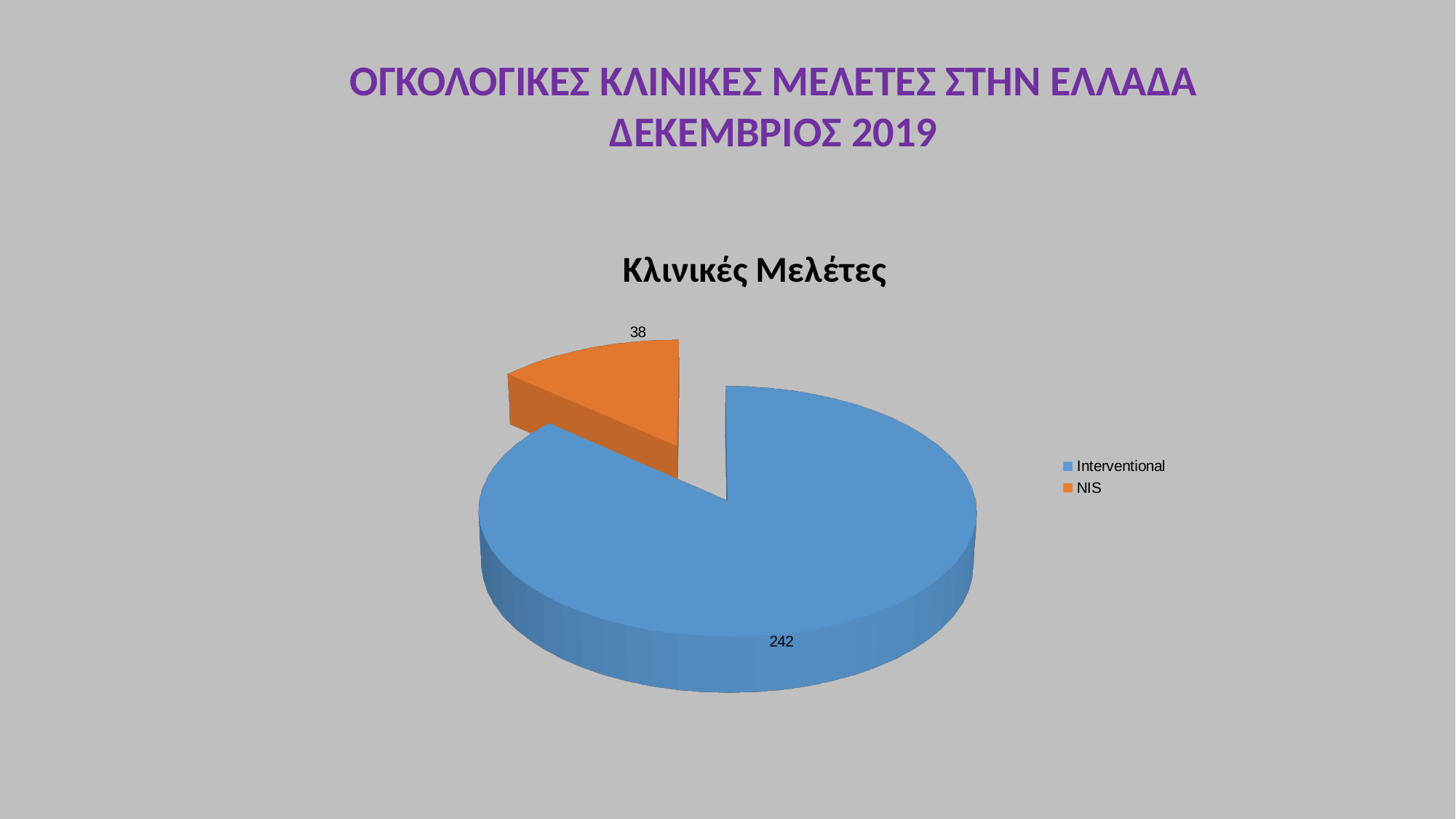
What is the title of the chart? Κλινικές Μελέτες What is the value for NIS? 38 What is the value for Interventional? 242 Which category has the smallest slice? NIS Which category has the largest slice? Interventional How many slices does the pie chart have? 2 What colour is the NIS slice? Orange How many entries does the legend list? 2 Which is larger, Interventional or NIS? Interventional What kind of chart is shown on the slide? Pie chart What is the total of all slices in the pie chart? 280 What is the difference between the Interventional and NIS values? 204